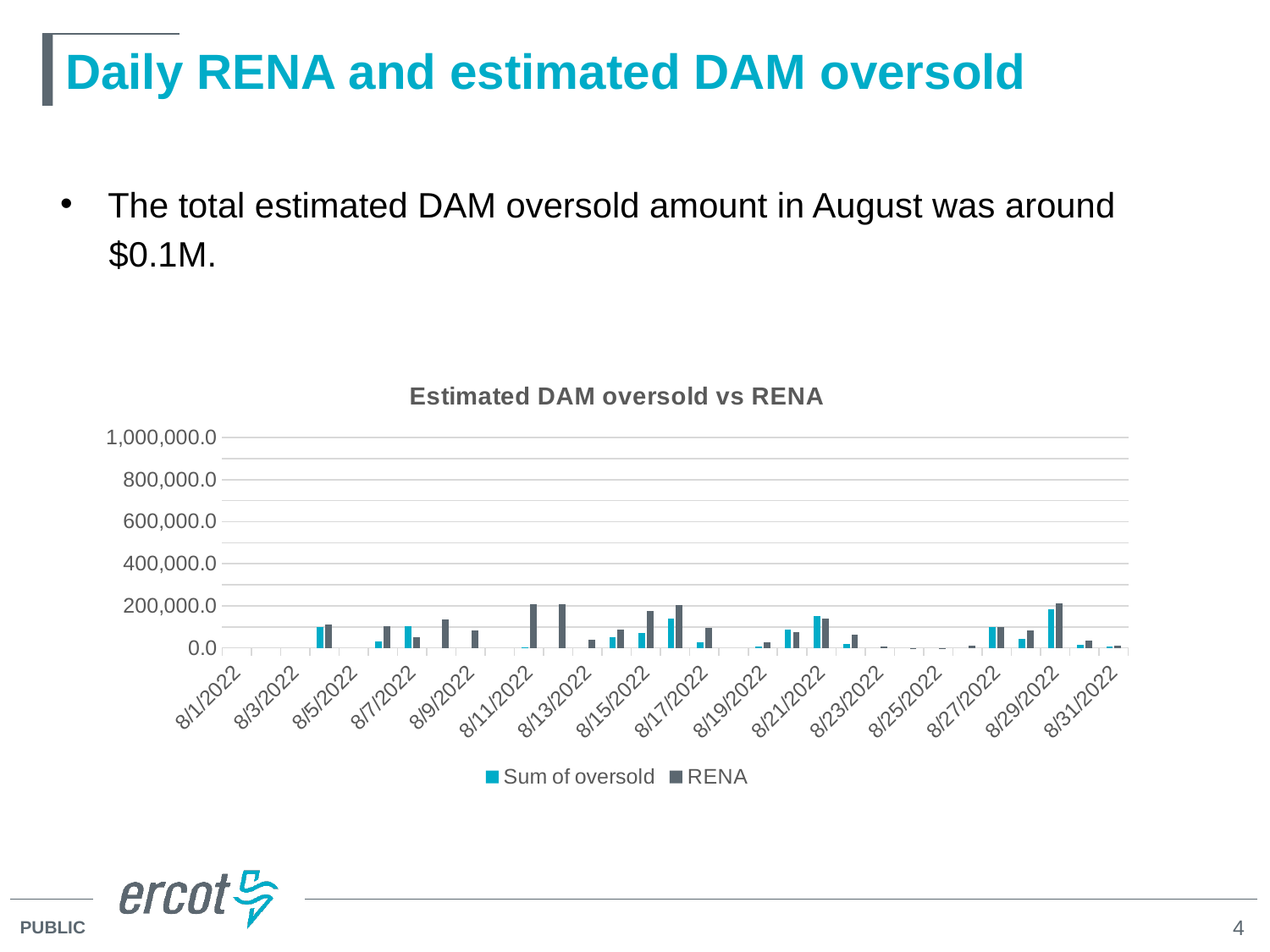
What is the title of the chart? Estimated DAM oversold vs RENA Is the value for RENA on 8/15/2022 greater or less than 100,000.0? greater On 8/15/2022, which is larger: Sum of oversold or RENA? RENA Is the value for RENA on 8/13/2022 greater or less than 400,000.0? less How many series does the legend of the chart list? 2 On 8/11/2022, which is larger: Sum of oversold or RENA? RENA What kind of chart is shown on the slide? Bar chart What is the highest value shown on the y axis of the chart? 1,000,000.0 Is the value for Sum of oversold on 8/29/2022 greater or less than 100,000.0? greater